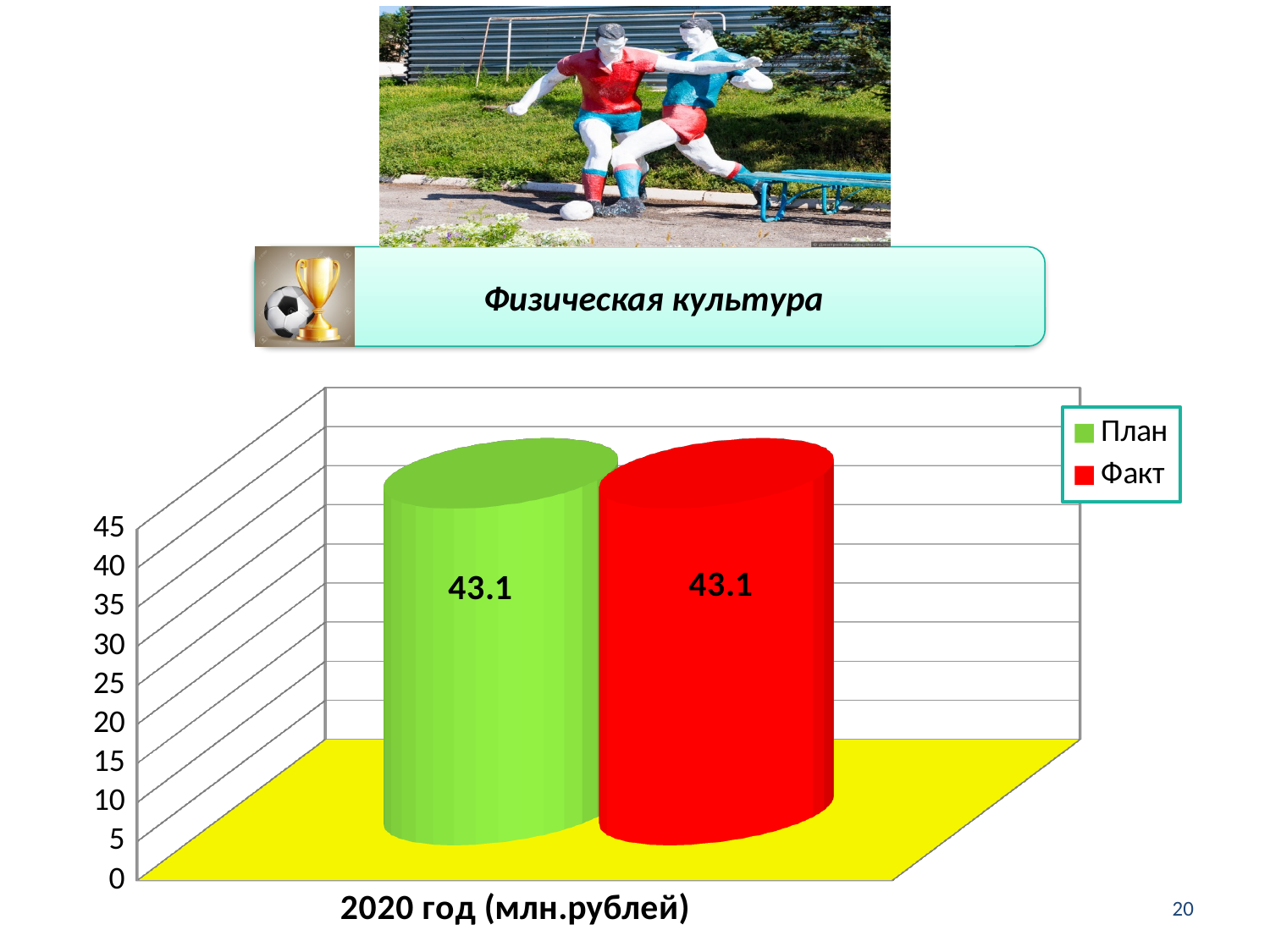
What is the difference between the План and Факт values for 2020? 0 What is the value for Факт (Fact) in 2020? 43.1 What kind of chart is shown on the slide? bar chart How many categories are shown on the x axis? 1 Is the value for План greater or less than 45? less What is the total of the План and Факт values for 2020? 86.2 What is the label of the category on the x axis? 2020 год (млн.рублей) Is the value for Факт greater or less than 40? greater How many series does the legend list? 2 What is the value for План (Plan) in 2020? 43.1 Which colour represents the Факт series? red